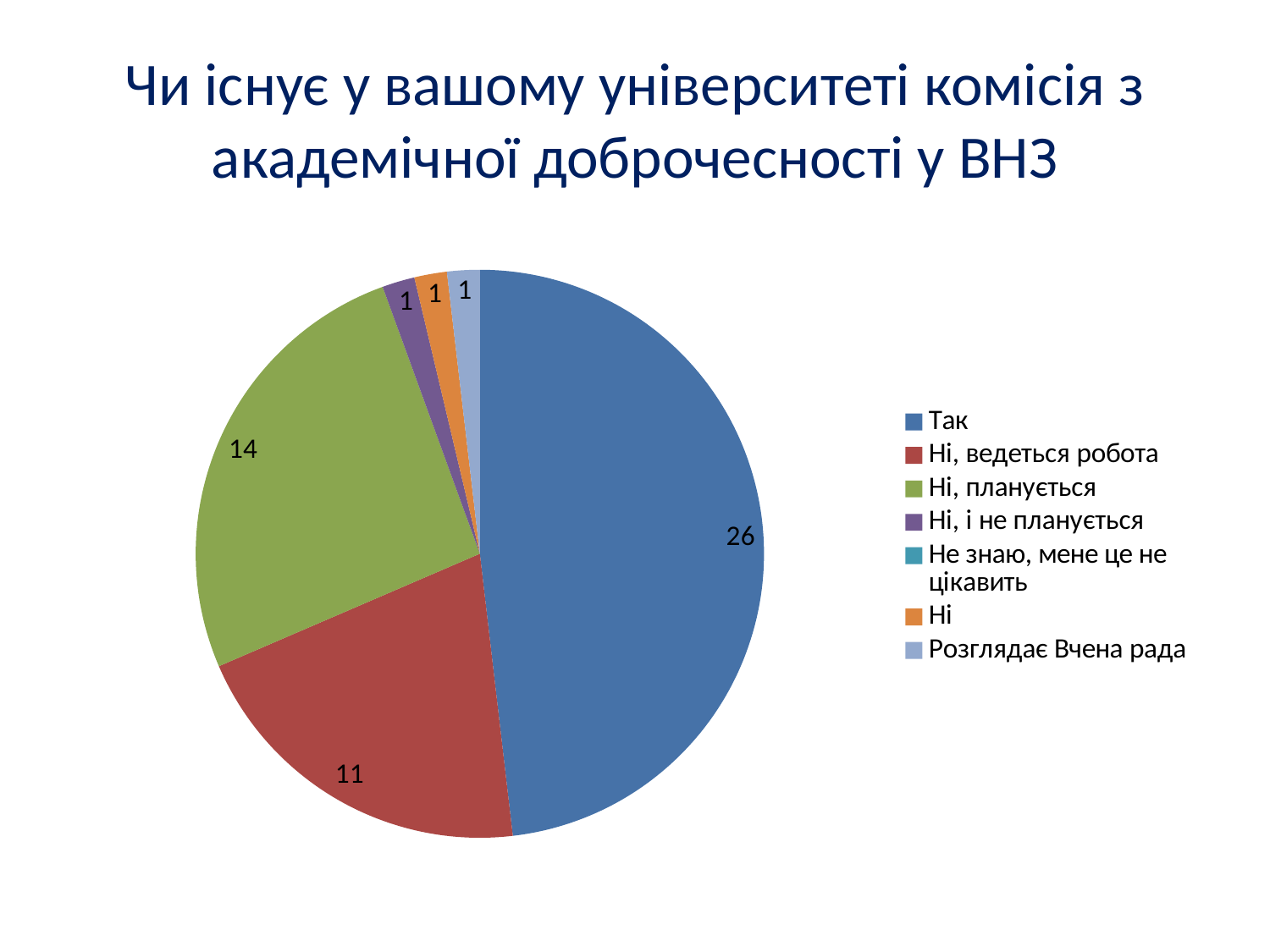
Which category has the largest slice of the pie? Так What colour is the slice for "Так"? Blue What is the difference between the values for "Так" and "Ні, планується"? 12 What is the value for "Розглядає Вчена рада"? 1 What is the value for "Ні, планується"? 14 What is the value for "Ні, ведеться робота"? 11 What is the value for "Ні, і не планується"? 1 What is the value for "Так"? 26 What is the difference between the values for "Ні, планується" and "Ні, ведеться робота"? 3 What kind of chart is shown on the slide? Pie chart Which is larger: "Ні, планується" or "Ні, ведеться робота"? Ні, планується How many entries does the legend list? 7